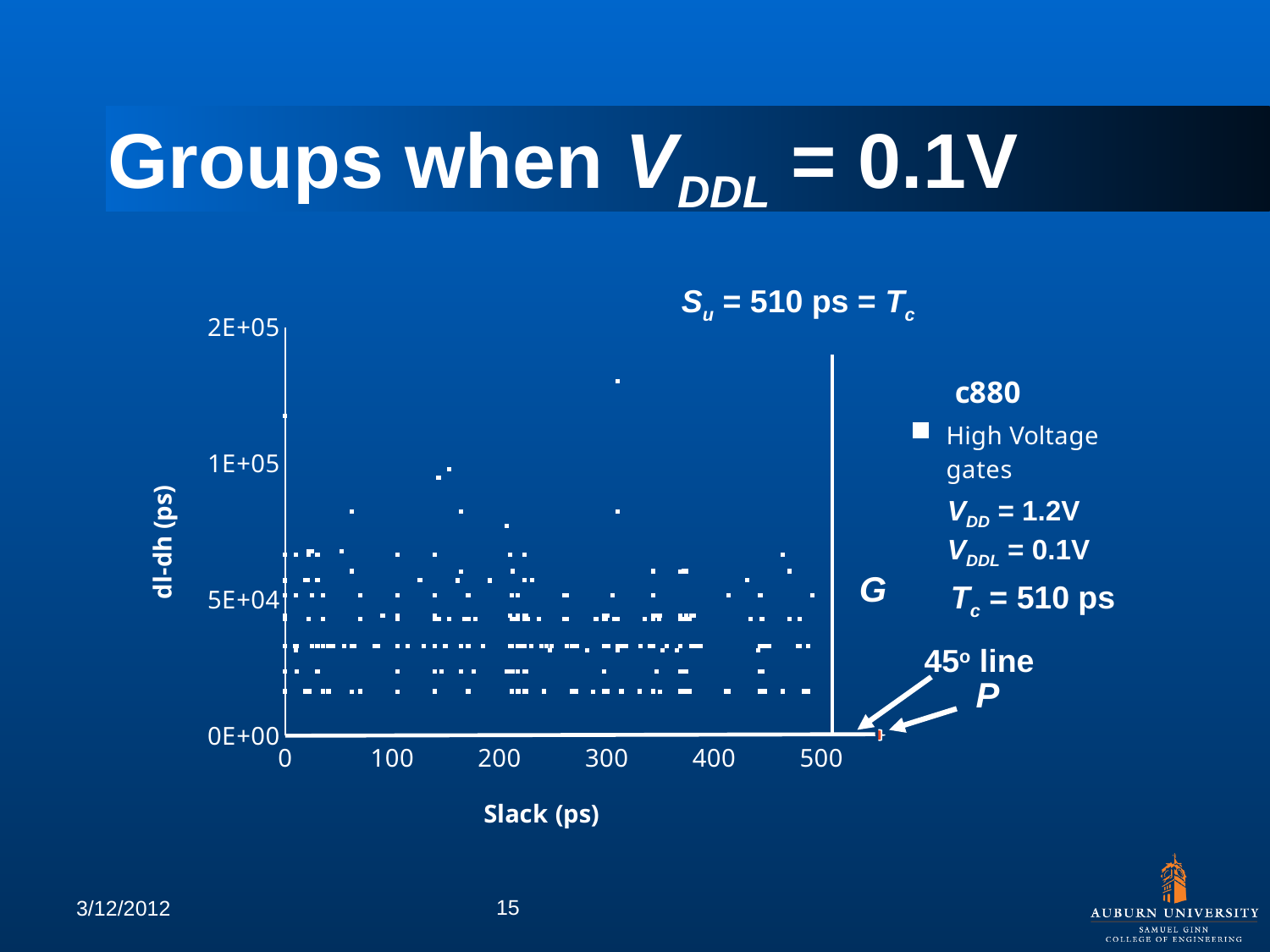
Is the slack value of the highest plotted point greater or less than 400? less Is the highest plotted dl-dh value on the chart greater or less than 1E+05? greater Is the slack value of the highest plotted point greater or less than 300? greater What is the largest tick value shown on the y axis of the chart? 2E+05 How many series does the chart legend list? 1 At what slack value is the vertical line labelled Su = Tc drawn on the chart? 510 ps What is the largest tick value shown on the x axis of the chart? 500 What is the title of the chart? c880 What is the label of the x axis of the chart? Slack (ps) What kind of chart is shown on the slide? Scatter chart